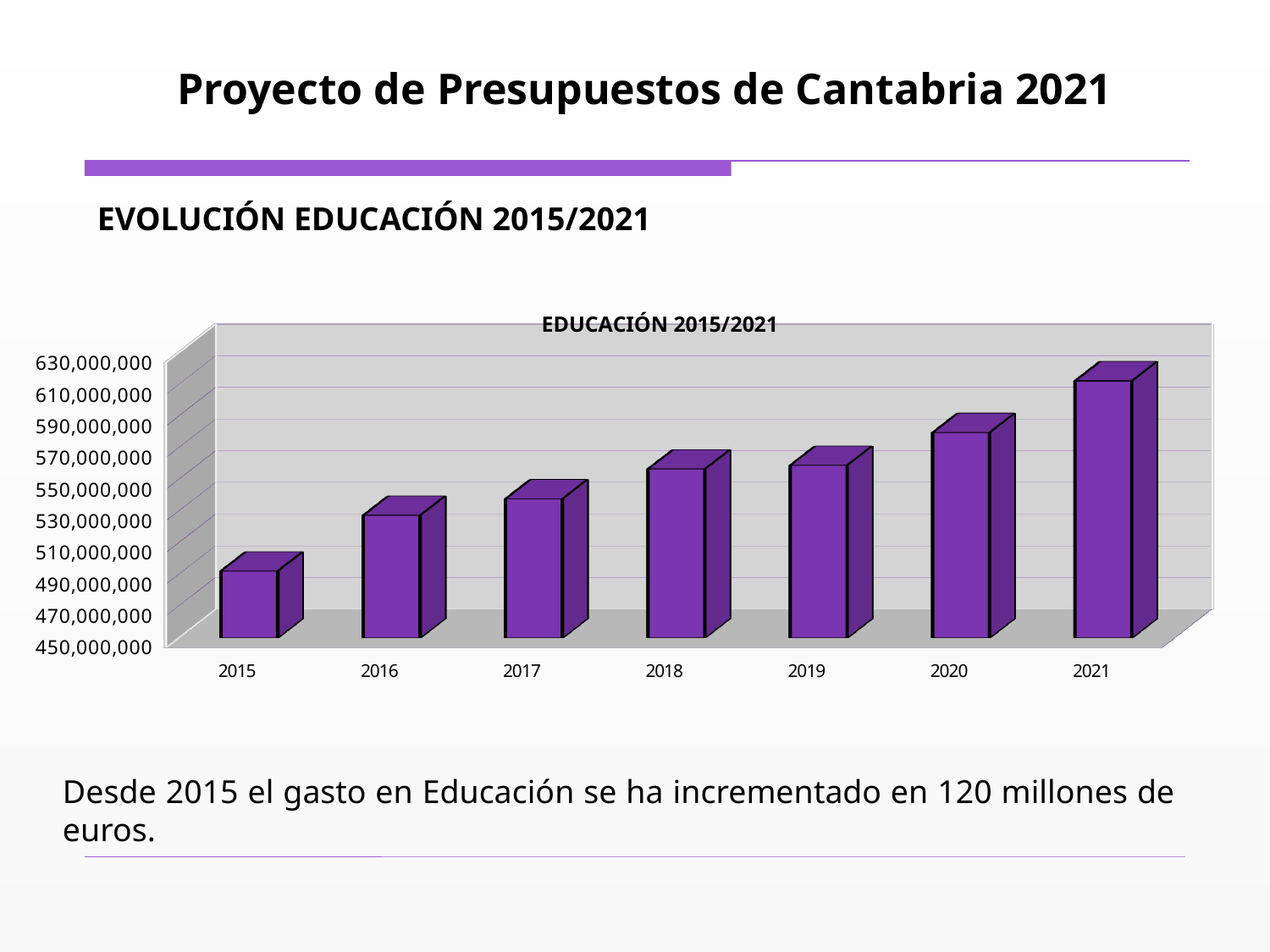
How many years are plotted on the x axis of the chart? 7 What colour are the bars in the chart? purple Is the value for 2020 greater or less than 570,000,000? greater Is the value for 2021 greater or less than 590,000,000? greater Which year has the lowest value in the chart? 2015 What is the title of the chart? EDUCACIÓN 2015/2021 Do the values rise or fall from 2015 to 2021? rise What kind of chart is shown on the slide? bar chart Which year has the highest value in the chart? 2021 Is the value for 2015 greater or less than 510,000,000? less Which is larger, the value for 2020 or the value for 2017? 2020